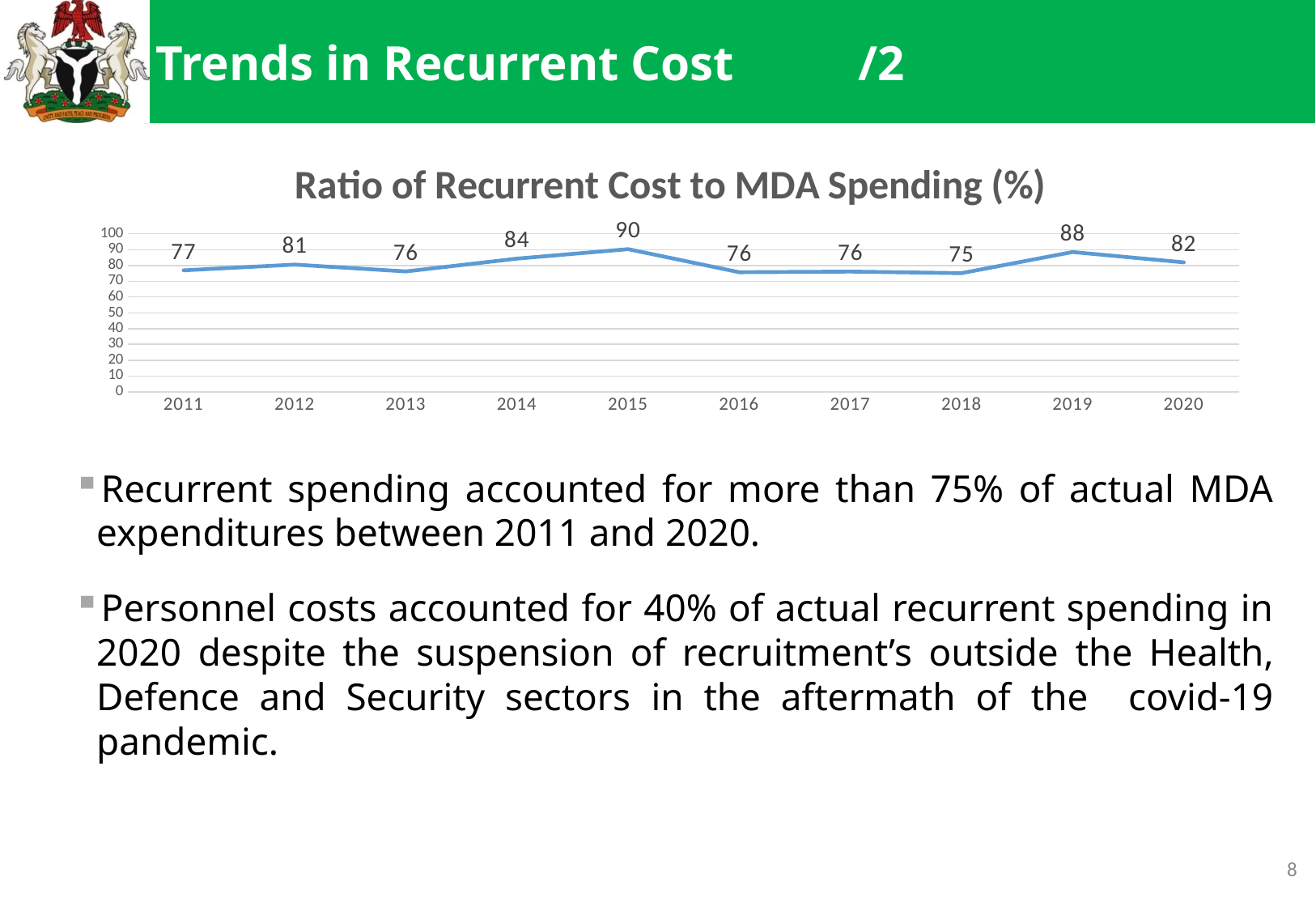
How many years are plotted on the chart? 10 What is the difference between the 2015 and 2018 values? 15 What is the ratio of recurrent cost to MDA spending in 2019? 88 What is the ratio of recurrent cost to MDA spending in 2015? 90 What is the ratio of recurrent cost to MDA spending in 2011? 77 What is the title of the chart? Ratio of Recurrent Cost to MDA Spending (%) Which year has the lowest ratio of recurrent cost to MDA spending? 2018 Is the value for 2016 greater or less than 80? less What is the difference between the 2019 and 2020 values? 6 What kind of chart is shown on the slide? line chart Which year has a larger value, 2012 or 2014? 2014 Which year has the highest ratio of recurrent cost to MDA spending? 2015